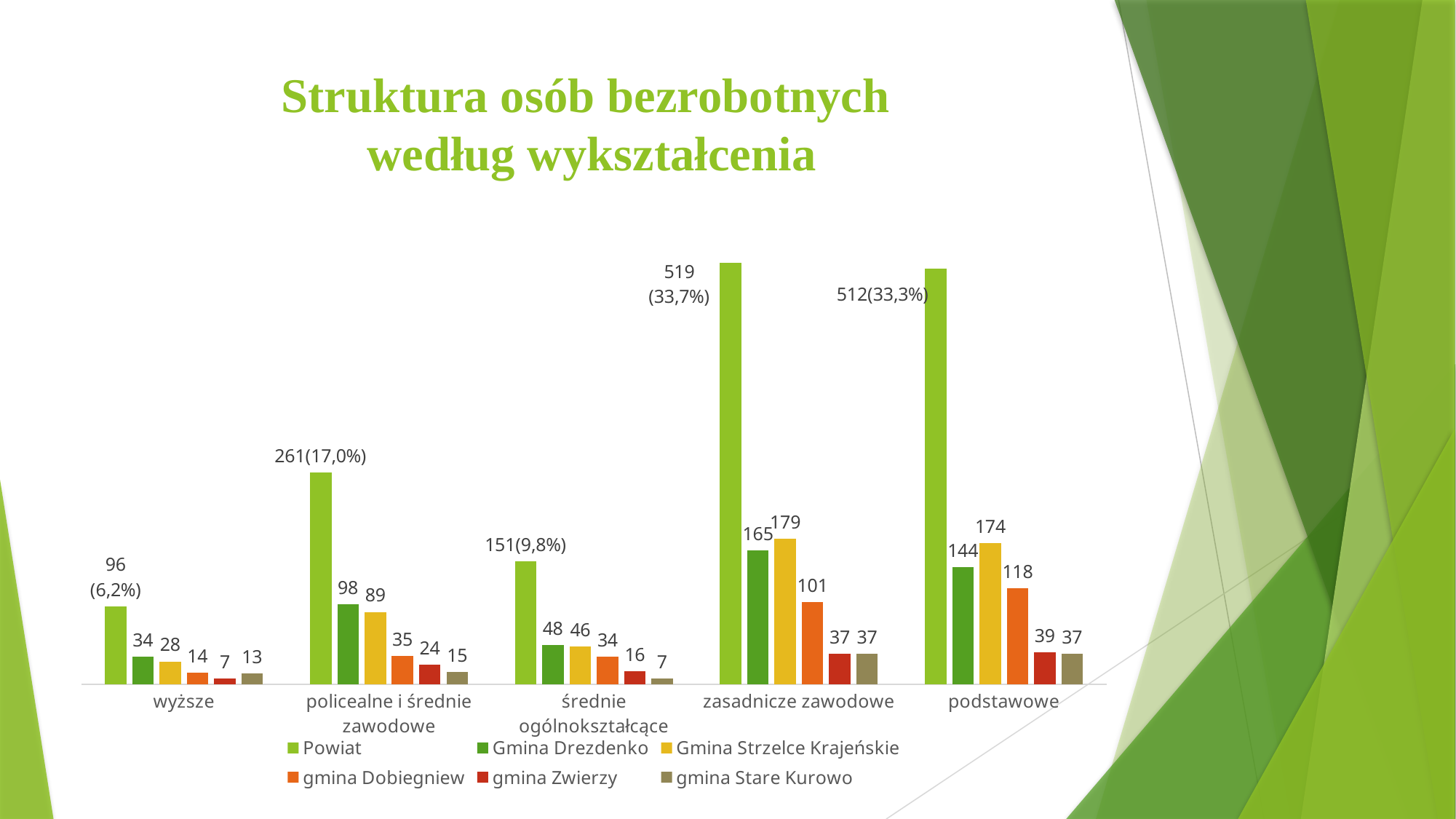
What is the value for gmina Zwierzy in the 'policealne i średnie zawodowe' category? 24 What is the title of the slide? Struktura osób bezrobotnych według wykształcenia What is the value for gmina Dobiegniew in the 'podstawowe' category? 118 What is the value for Gmina Strzelce Krajeńskie in the 'zasadnicze zawodowe' category? 179 How many series does the legend list? 6 Which is larger in the 'średnie ogólnokształcące' category: Gmina Drezdenko or gmina Dobiegniew? Gmina Drezdenko In which category is the Gmina Drezdenko value lowest? wyższe What kind of chart is shown on the slide? bar chart What is the value for Powiat in the 'wyższe' category? 96 (6,2%) How many education categories are shown on the x axis? 5 In which category is the Powiat value highest? zasadnicze zawodowe What is the difference between the Gmina Drezdenko values for 'zasadnicze zawodowe' and 'podstawowe'? 21